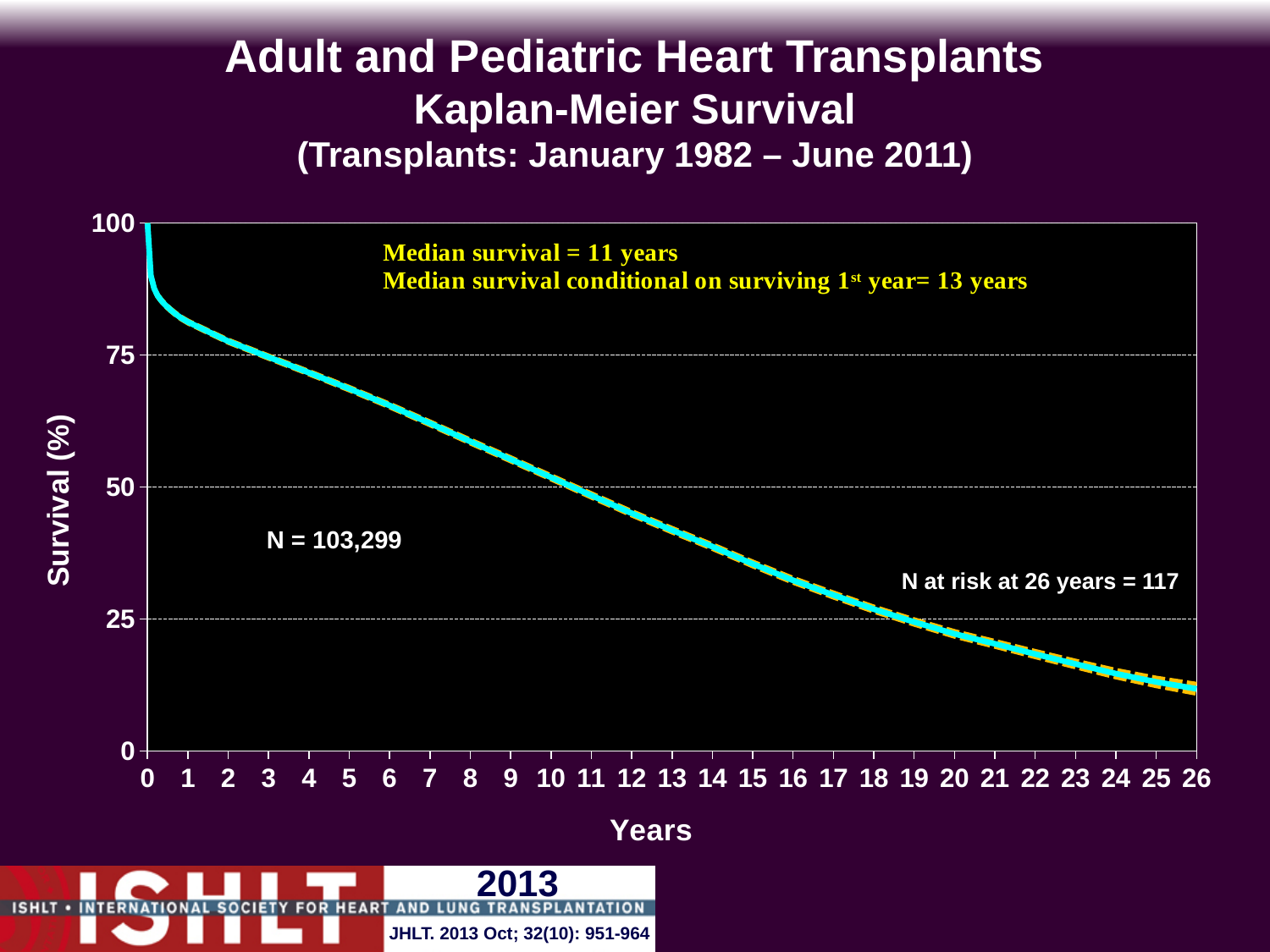
What kind of chart is shown on the slide? line chart What is the median survival stated on the chart? 11 years What is the N at risk at 26 years? 117 Is the survival value at 20 years greater or less than 25? less Does survival rise or fall as years since transplant increase? fall What is the median survival conditional on surviving the 1st year? 13 years Is the survival value at 15 years greater or less than 50? less Is the survival value at 5 years greater or less than 50? greater What is the value of N shown on the chart? 103,299 What is the label of the y axis? Survival (%) What transplant date range is given in the chart title? January 1982 – June 2011